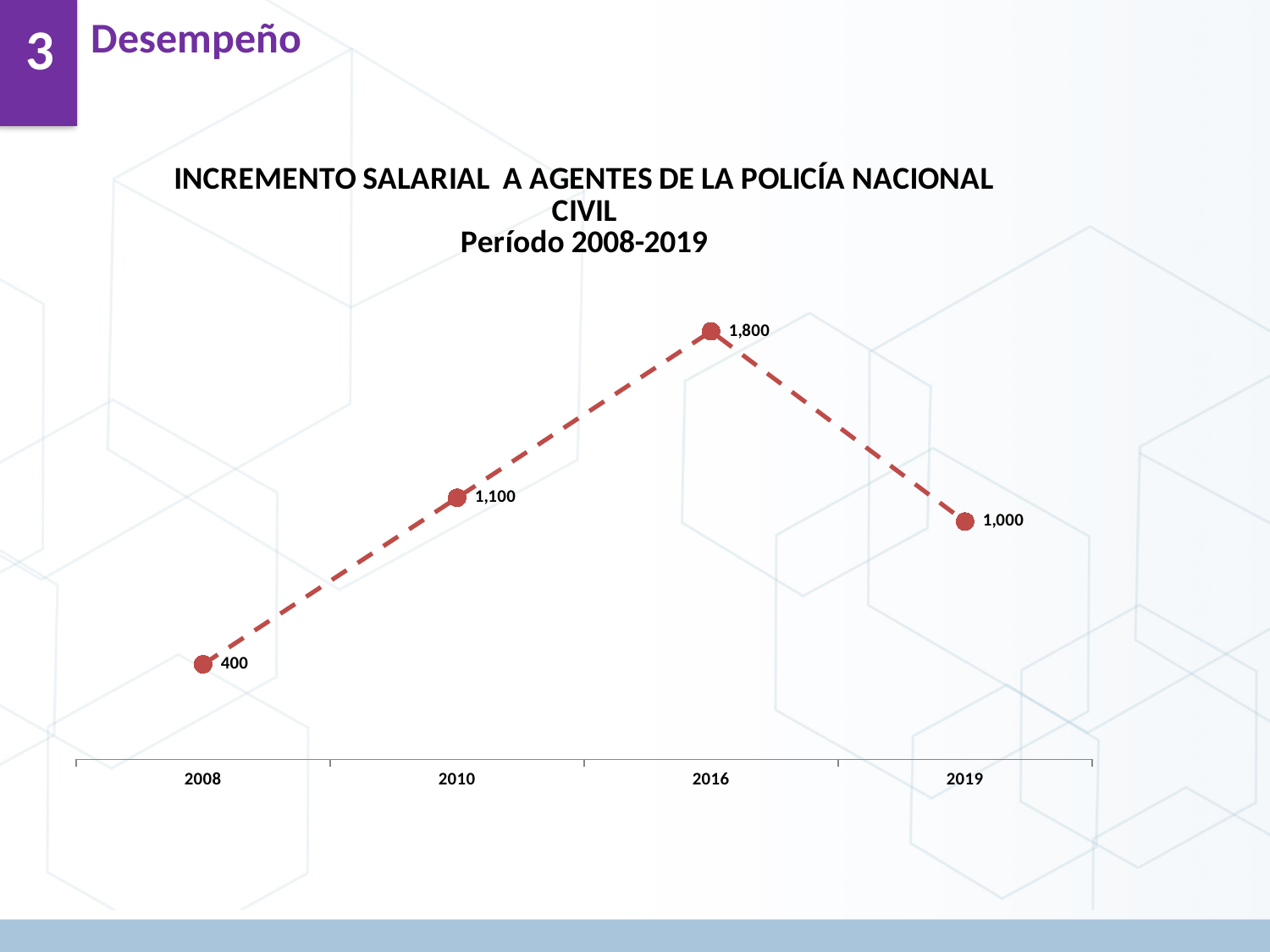
What is the value for 2010? 1,100 What is the title of the chart? INCREMENTO SALARIAL A AGENTES DE LA POLICÍA NACIONAL CIVIL Período 2008-2019 What is the value for 2008? 400 How many data points are plotted on the chart? 4 What is the value for 2019? 1,000 Which is larger, the value for 2010 or the value for 2019? 2010 What is the value for 2016? 1,800 Which year has the lowest value? 2008 What kind of chart is shown on the slide? Line chart What is the difference between the values for 2016 and 2019? 800 Which year has the highest value? 2016 What is the difference between the values for 2010 and 2008? 700